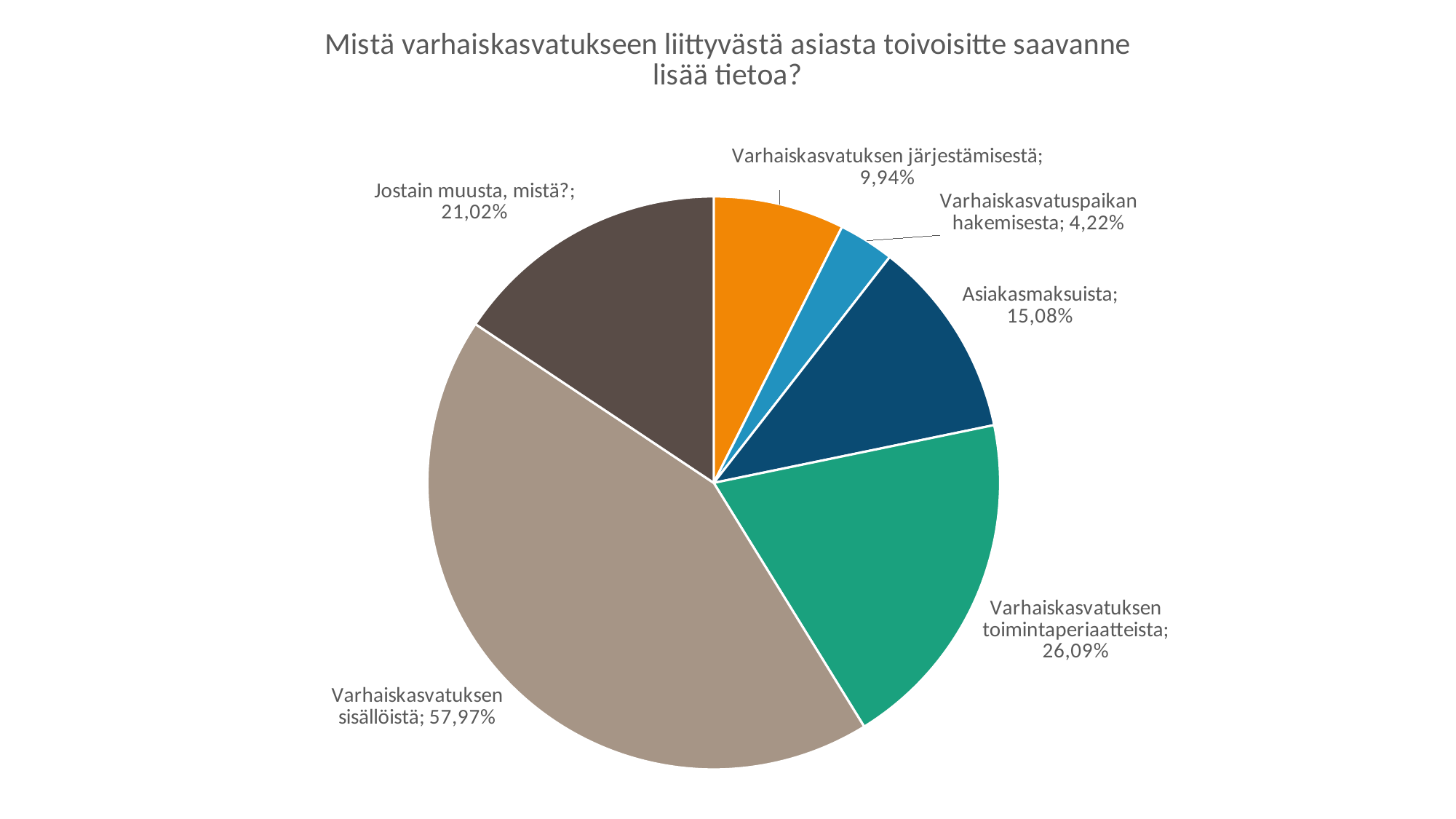
What is the value shown for "Varhaiskasvatuksen järjestämisestä"? 9,94% What is the value shown for "Asiakasmaksuista"? 15,08% What is the difference between the values for "Varhaiskasvatuksen sisällöistä" and "Varhaiskasvatuksen toimintaperiaatteista"? 31,88% What is the value shown for "Varhaiskasvatuksen sisällöistä"? 57,97% What is the value shown for "Varhaiskasvatuspaikan hakemisesta"? 4,22% What is the value shown for "Jostain muusta, mistä?"? 21,02% What is the title of the chart? Mistä varhaiskasvatukseen liittyvästä asiasta toivoisitte saavanne lisää tietoa? Which category has the largest slice of the pie? Varhaiskasvatuksen sisällöistä How many slices does the pie chart have? 6 Which is larger: "Varhaiskasvatuksen toimintaperiaatteista" or "Jostain muusta, mistä?"? Varhaiskasvatuksen toimintaperiaatteista Which category has the smallest slice of the pie? Varhaiskasvatuspaikan hakemisesta What kind of chart is shown on the slide? Pie chart